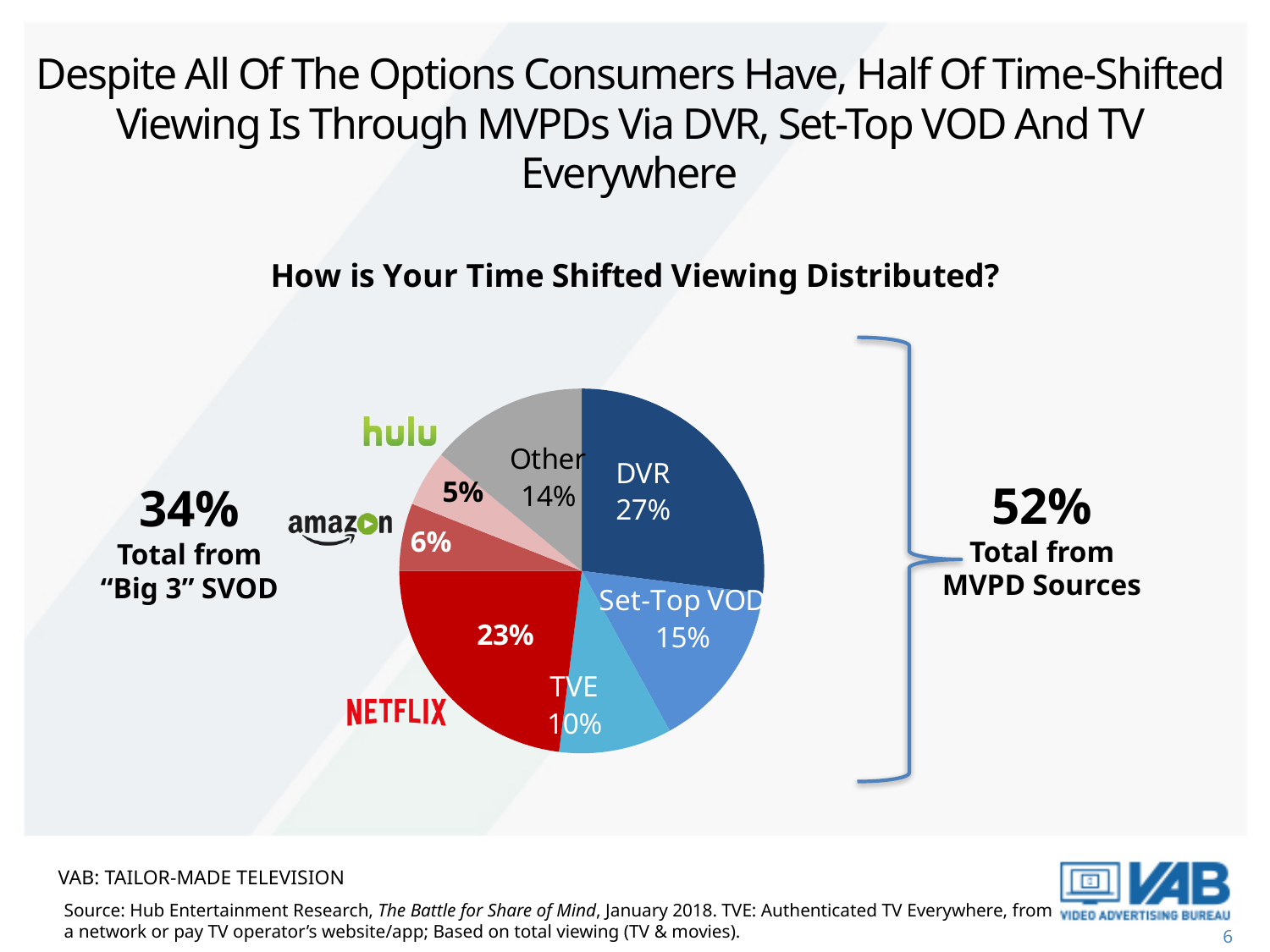
What share of time-shifted viewing is through Netflix? 23% What is the difference between the DVR share and the Netflix share? 4% What kind of chart is shown on the slide? pie chart Which slice of the pie is the smallest? Hulu What share of time-shifted viewing is through DVR? 27% What share of time-shifted viewing is through Hulu? 5% How many slices does the pie chart have? 7 What share of time-shifted viewing is through TVE? 10% Which slice of the pie is the largest? DVR What is the title of the chart? How is Your Time Shifted Viewing Distributed? Which is larger, the Set-Top VOD share or the Other share? Set-Top VOD What share of time-shifted viewing is through Set-Top VOD? 15%